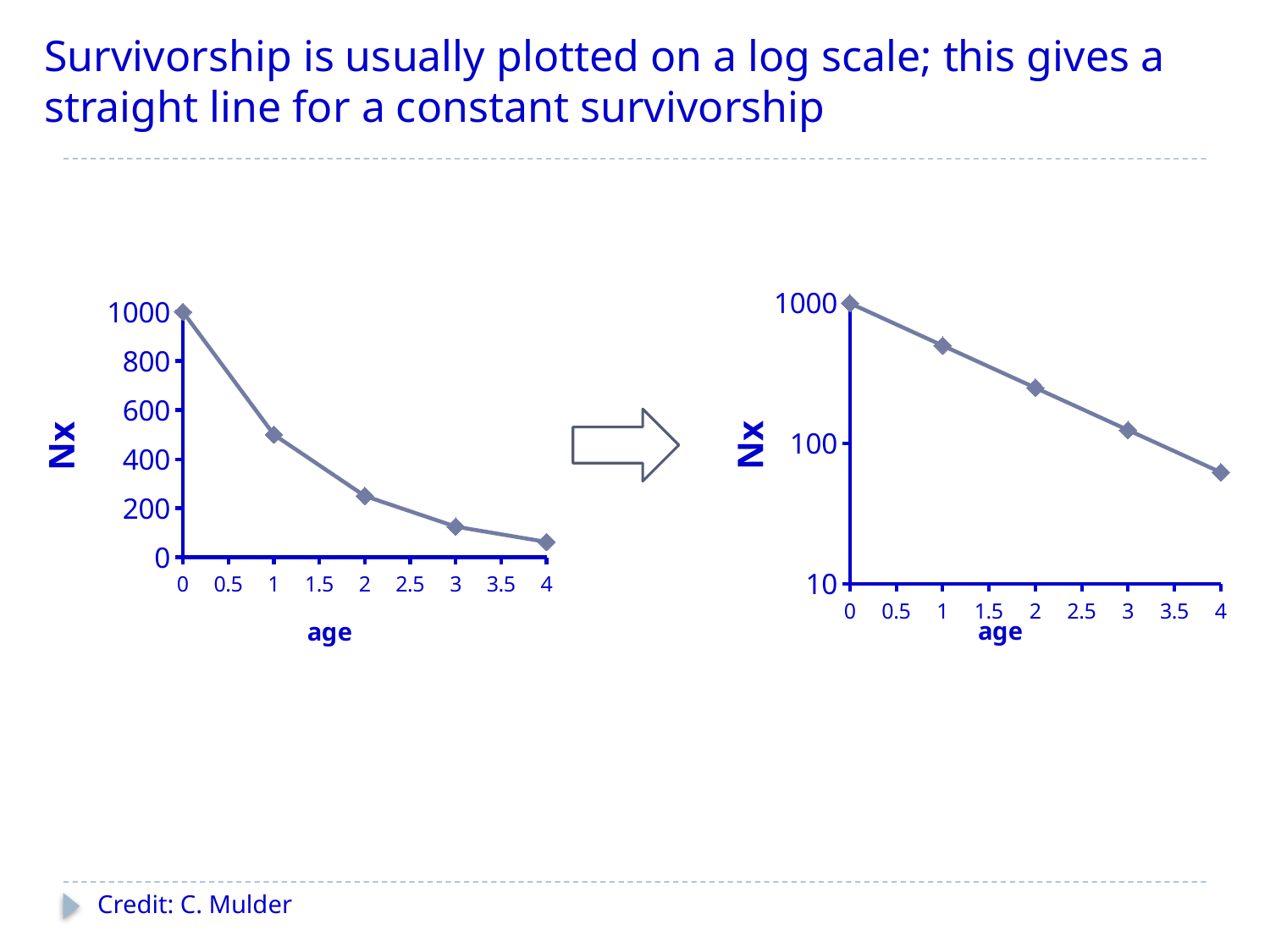
On the left chart, at which age is Nx highest? 0 On the left chart, which has the larger Nx value, age 1 or age 3? age 1 On the right chart, is the value of Nx at age 4 greater or less than 100? less On the left chart, is the value of Nx at age 1 greater or less than 400? greater On the right chart, does Nx rise or fall as age increases? fall On the left chart, what is the value of Nx at age 0? 1000 On the left chart, at which age is Nx lowest? 4 On the right chart, what is the value of Nx at age 0? 1000 On the left chart, is the value of Nx at age 3 greater or less than 200? less What kind of chart is the left chart? line chart How many data points are plotted on the right chart? 5